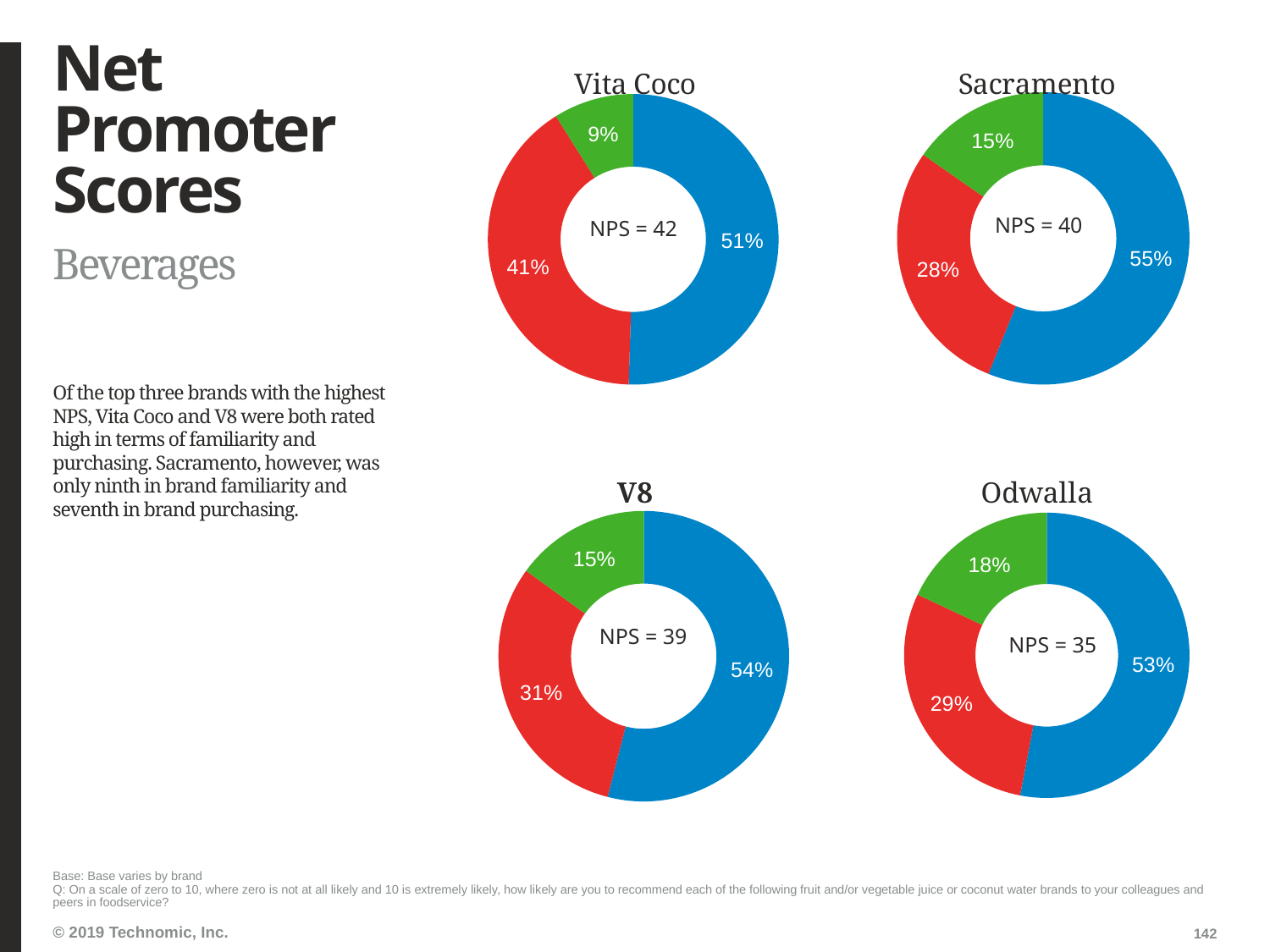
In the V8 chart, what percentage is shown for the green slice? 15% How many slices does the Vita Coco chart have? 3 In the Odwalla chart, what is the difference between the blue slice and the red slice? 24% In the Sacramento chart, what percentage is shown for the red slice? 28% In the V8 chart, which is larger, the red slice or the green slice? Red How many donut charts are shown on the slide? 4 In the Odwalla chart, what NPS value is printed in the centre of the donut? NPS = 35 In the Vita Coco chart, what percentage is shown for the blue slice? 51% What kind of chart is used for Sacramento? Donut (pie) chart Which of the four charts shows the highest NPS value? Vita Coco In the Sacramento chart, which colour slice is the largest? Blue In the Vita Coco chart, which colour slice is the smallest? Green